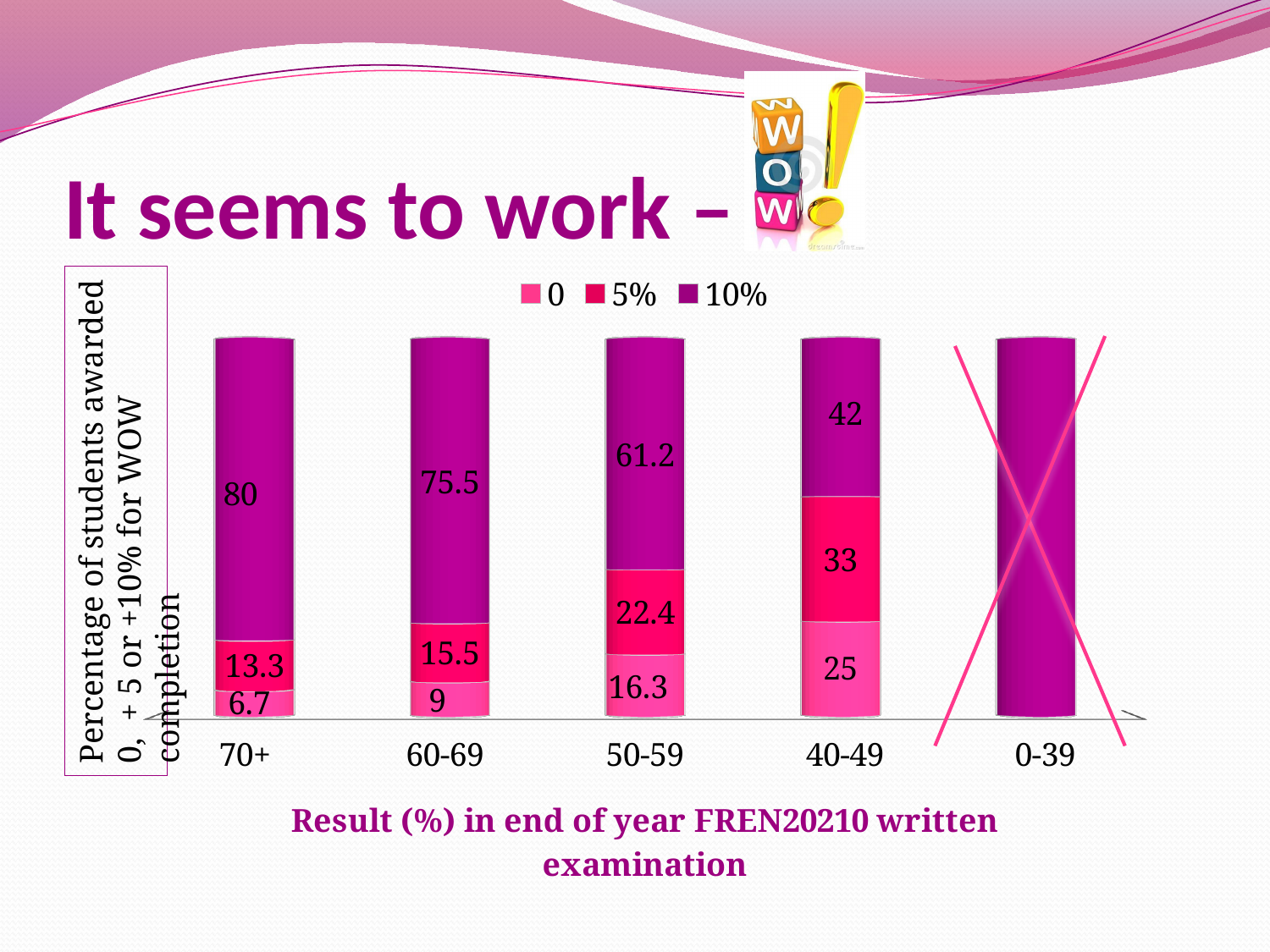
What kind of chart is shown on the slide? Stacked bar chart What is the x-axis title of the chart? Result (%) in end of year FREN20210 written examination How many series does the legend list? 3 What is the value of the 0 series for the 40-49 category? 25 How many categories are shown on the x axis? 5 What is the value of the 10% series for the 70+ category? 80 What is the difference between the 10% series values for 70+ and 40-49? 38 Which is larger: the 5% series value for 60-69 or for 40-49? 40-49 What is the value of the 5% series for the 50-59 category? 22.4 What is the value of the 0 series for the 60-69 category? 9 Which category has the lowest value for the 0 series? 70+